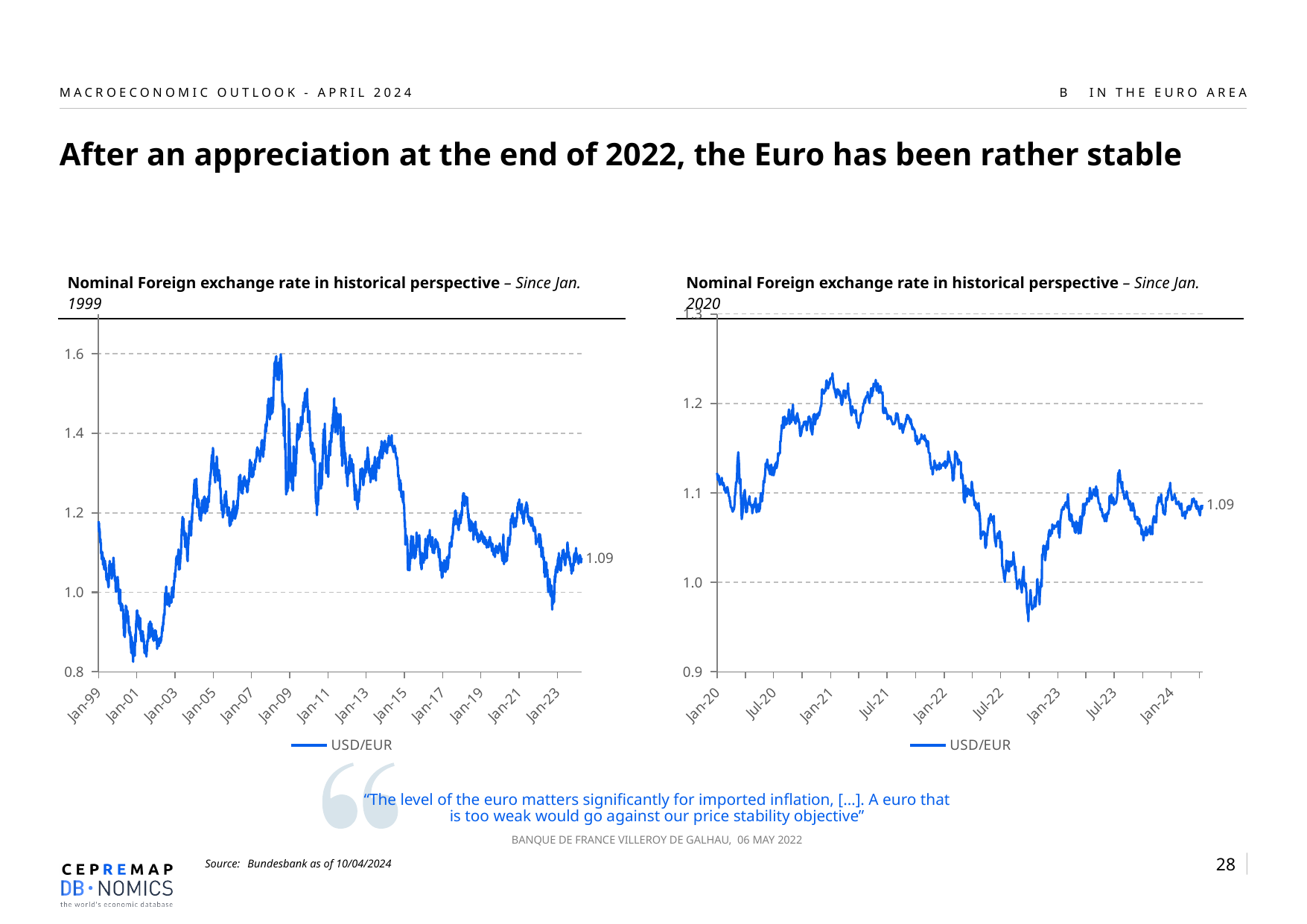
In the right chart (since Jan. 2020), is the USD/EUR value around Jan-21 greater or less than 1.2? greater In the right chart (since Jan. 2020), what is the latest USD/EUR value labelled at the end of the line? 1.09 What series name is shown in the legend of the right chart (since Jan. 2020)? USD/EUR In the left chart (since Jan. 1999), what is the latest USD/EUR value labelled at the end of the line? 1.09 How many series does the legend of the left chart (since Jan. 1999) list? 1 What kind of chart is the left chart, 'Nominal Foreign exchange rate in historical perspective – Since Jan. 1999'? Line chart In the left chart (since Jan. 1999), is the USD/EUR value around Jan-03 greater or less than 1.2? less What kind of chart is the right chart, 'Nominal Foreign exchange rate in historical perspective – Since Jan. 2020'? Line chart In the right chart (since Jan. 2020), does the USD/EUR line rise or fall between Jan-21 and Jul-22? fall In the left chart (since Jan. 1999), is the USD/EUR value around Jan-01 greater or less than 1.0? less How many series does the legend of the right chart (since Jan. 2020) list? 1